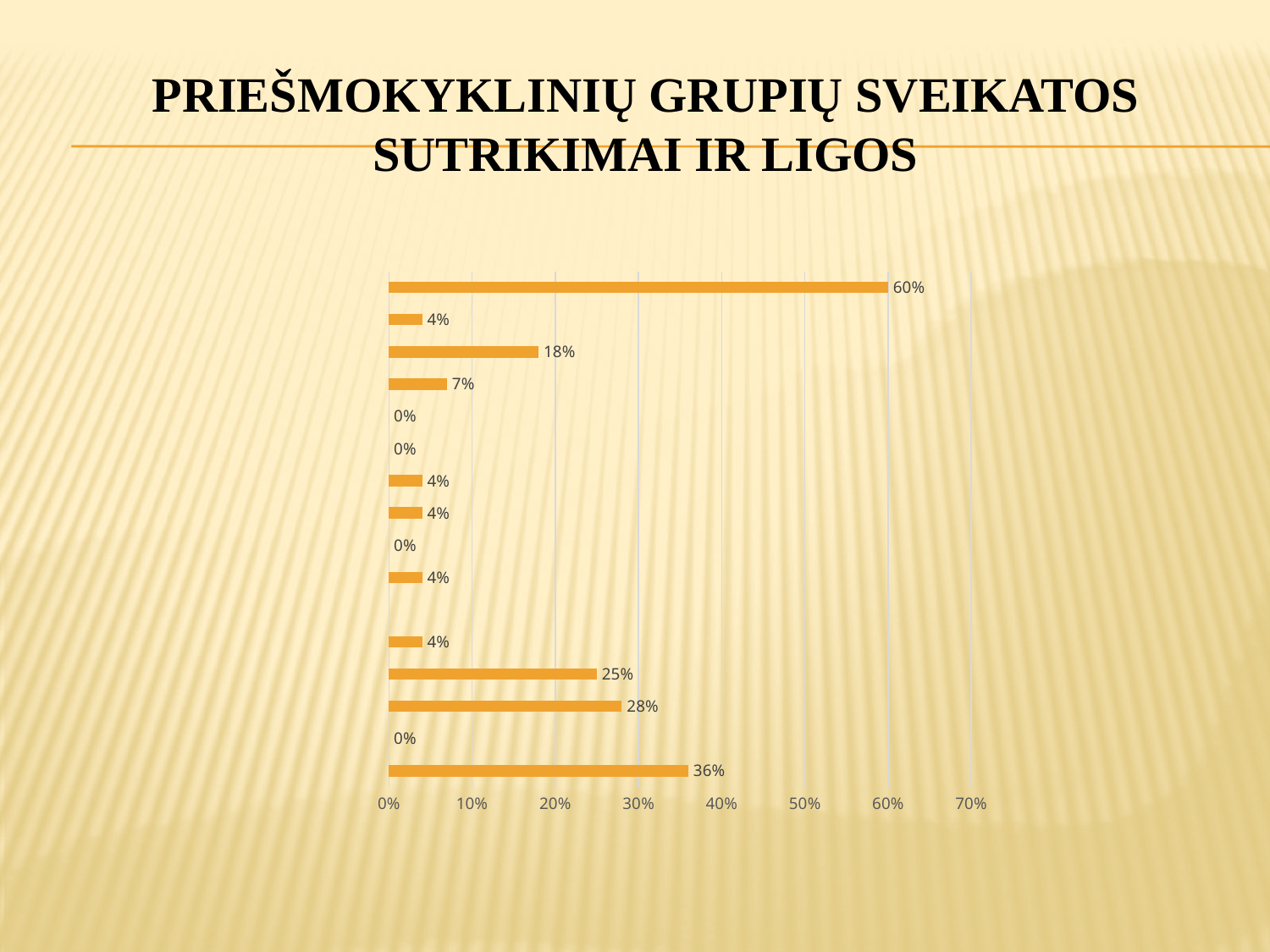
What is the difference between the bars labelled 28% and 25%? 3% What is the value of the third bar from the top? 18% What is the difference between the topmost bar (60%) and the bottom bar (36%)? 24% What is the value of the topmost bar in the chart? 60% Which is larger, the topmost bar or the bottom bar? the topmost bar What is the highest value shown by any bar in the chart? 60% What kind of chart is shown on the slide? bar chart What is the value of the bottom bar in the chart? 36% What is the highest tick value shown on the horizontal axis? 70% What is the title of the slide containing the chart? PRIEŠMOKYKLINIŲ GRUPIŲ SVEIKATOS SUTRIKIMAI IR LIGOS Is the value of the topmost bar greater or less than 50%? greater What is the value of the fourth bar from the top? 7%